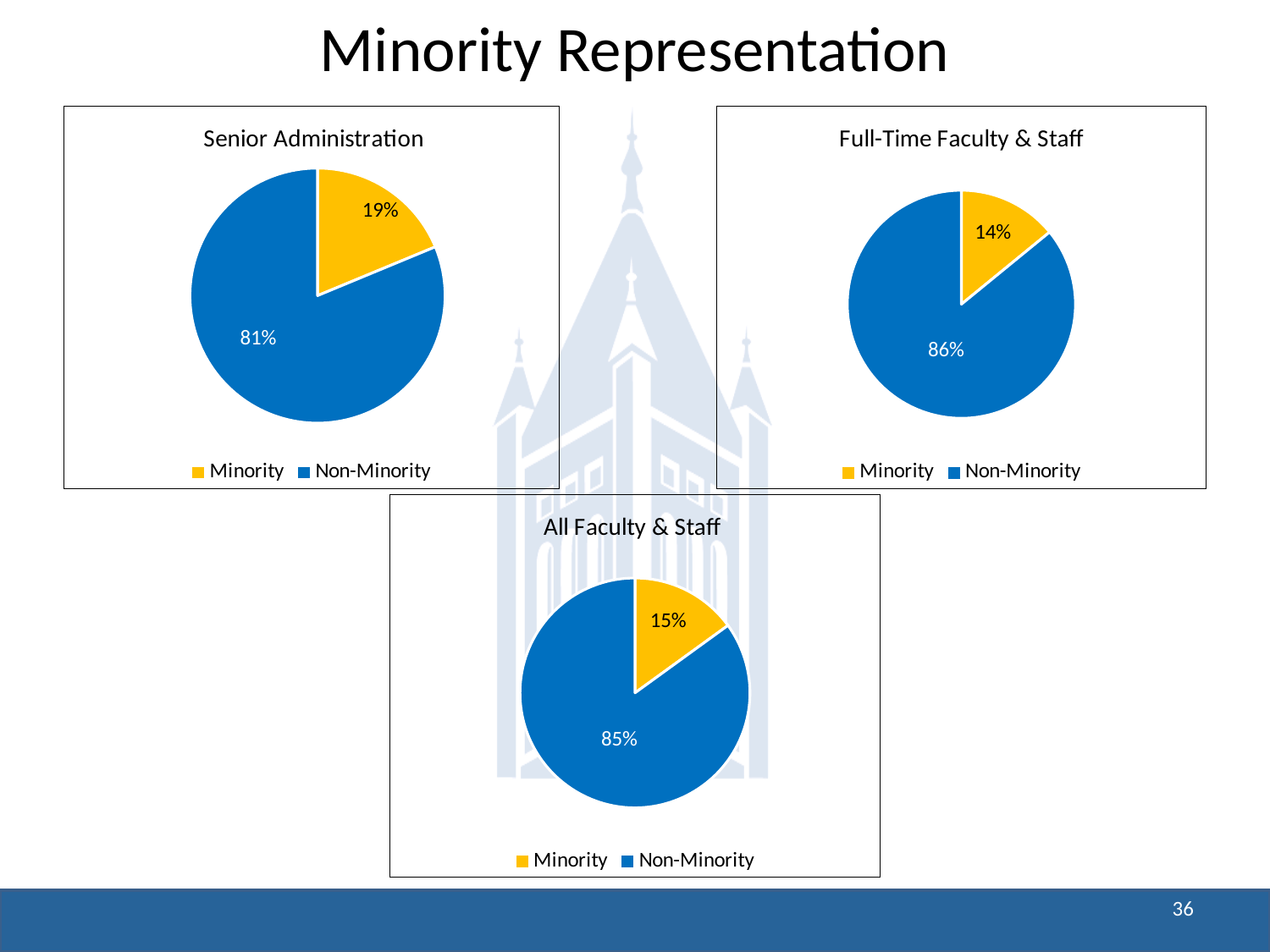
In the Full-Time Faculty & Staff chart, what percentage is Minority? 14% In the Senior Administration chart, what percentage is Minority? 19% In the All Faculty & Staff chart, what percentage is Non-Minority? 85% In the All Faculty & Staff chart, what colour is the Minority slice? Yellow In the Full-Time Faculty & Staff chart, what is the difference between the Non-Minority and Minority percentages? 72% In the Full-Time Faculty & Staff chart, what percentage is Non-Minority? 86% In the Senior Administration chart, what percentage is Non-Minority? 81% In the All Faculty & Staff chart, what percentage is Minority? 15% What type of chart is the All Faculty & Staff chart? Pie chart How many slices does the Senior Administration pie chart have? 2 How many entries does the legend of the Full-Time Faculty & Staff chart list? 2 In the Senior Administration chart, which slice is larger, Minority or Non-Minority? Non-Minority